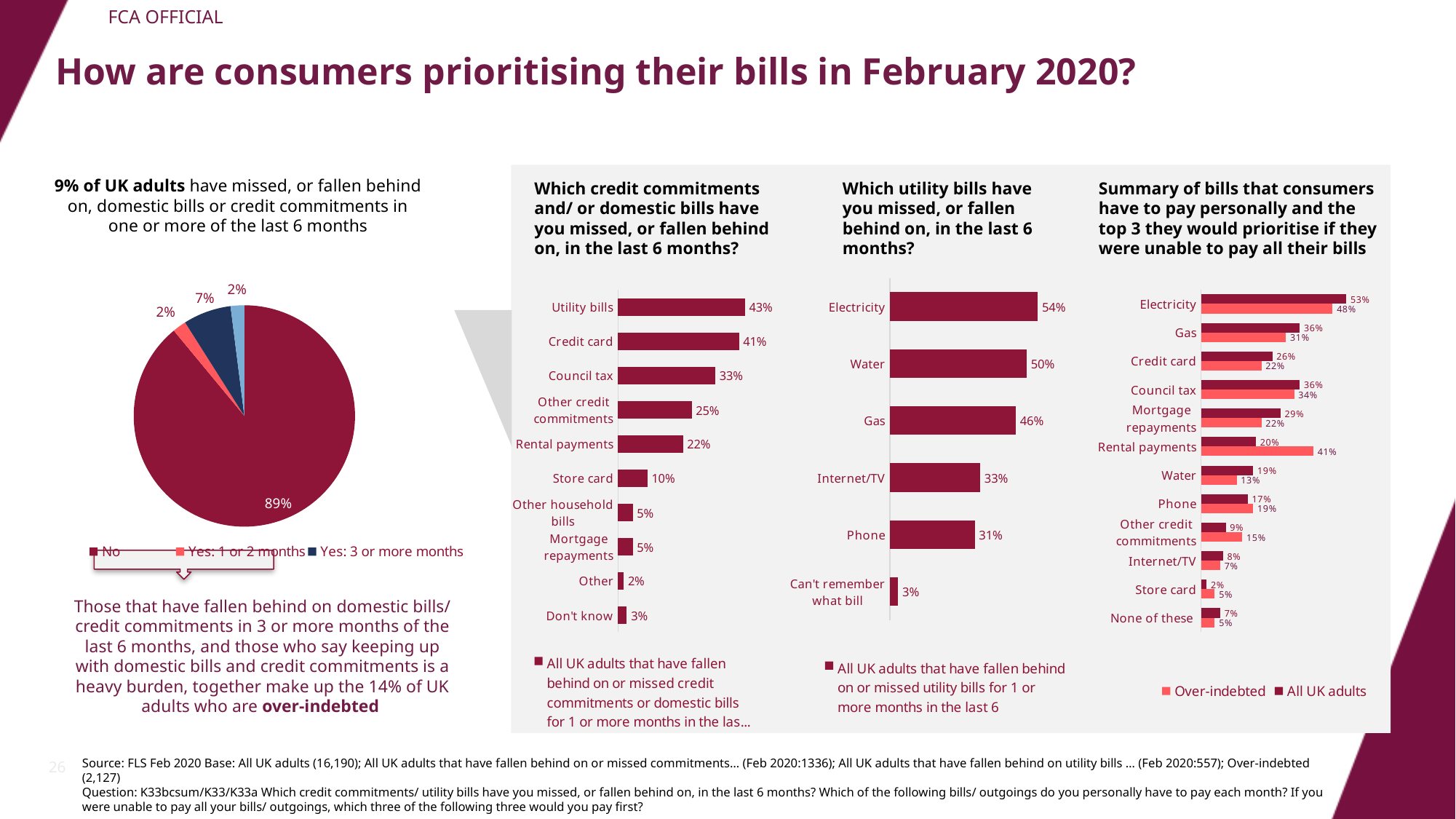
How many categories are shown in the chart 'Which credit commitments and/or domestic bills have you missed, or fallen behind on, in the last 6 months?'? 10 What type of chart is used for 'Which utility bills have you missed, or fallen behind on, in the last 6 months?'? Bar chart In the pie chart on the left, what share of UK adults answered 'No'? 89% In the chart 'Which credit commitments and/or domestic bills have you missed, or fallen behind on, in the last 6 months?', what is the difference between Utility bills and Rental payments? 21% In the pie chart on the left, what percentage answered 'Yes: 3 or more months'? 7% In the chart 'Which utility bills have you missed, or fallen behind on, in the last 6 months?', which is larger, Internet/TV or Phone? Internet/TV In the 'Summary of bills that consumers have to pay personally' chart, what is the Over-indebted value for Rental payments? 41% In the chart 'Which utility bills have you missed, or fallen behind on, in the last 6 months?', which category has the lowest value? Can't remember what bill In the chart 'Which credit commitments and/or domestic bills have you missed, or fallen behind on, in the last 6 months?', what is the value for Council tax? 33% In the chart 'Which credit commitments and/or domestic bills have you missed, or fallen behind on, in the last 6 months?', which category has the highest value? Utility bills In the chart 'Which utility bills have you missed, or fallen behind on, in the last 6 months?', what is the value for Gas? 46% How many series does the legend list in the 'Summary of bills that consumers have to pay personally' chart? 2